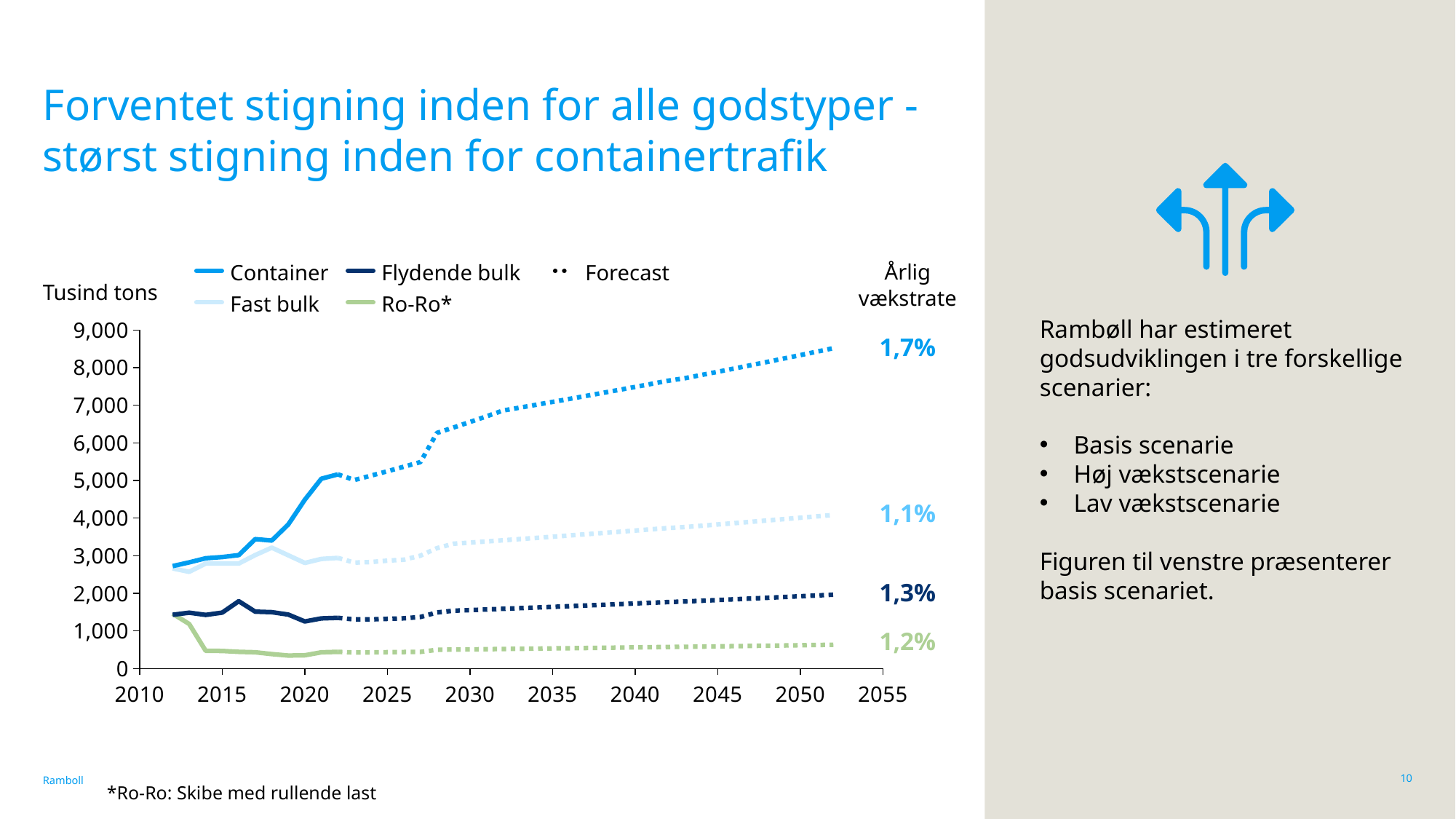
What is the annual growth rate shown for Fast bulk? 1,1% What is the annual growth rate (Årlig vækstrate) shown for Container? 1,7% What is the annual growth rate shown for Ro-Ro*? 1,2% Which series has the lowest values throughout the forecast period? Ro-Ro* Is the Container value around 2052 greater or less than 8,000? greater Which series has the lowest annual growth rate? Fast bulk What kind of chart is shown on the slide? line chart Which series has the highest annual growth rate? Container What is the annual growth rate shown for Flydende bulk? 1,3% What unit is given for the y axis? Tusind tons Does the Container series rise or fall from 2012 to 2052? rise Which series has the highest values at the end of the forecast period (around 2052)? Container